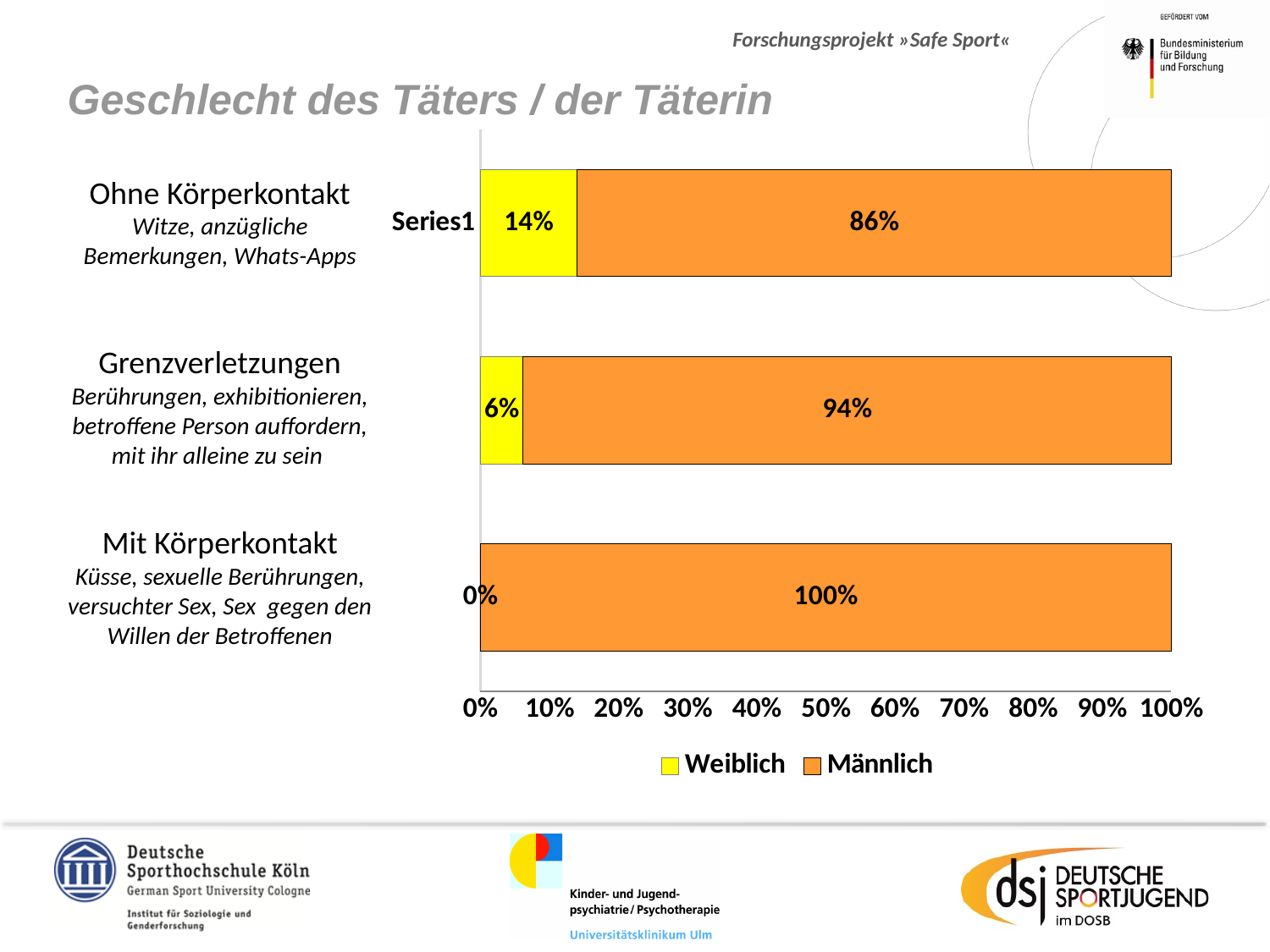
Which is larger for Ohne Körperkontakt, the Weiblich share or the Männlich share? Männlich What is the Männlich share for Ohne Körperkontakt? 86% What kind of chart is shown on the slide? stacked bar chart What is the Weiblich share for Grenzverletzungen? 6% How many series does the legend list? 2 Which category has the highest Weiblich share? Ohne Körperkontakt What is the difference between the Männlich and Weiblich shares for Grenzverletzungen? 88% How many categories (bars) are shown in the chart? 3 Which category has the lowest Weiblich share? Mit Körperkontakt What is the Männlich share for Mit Körperkontakt? 100% What is the Weiblich share for Ohne Körperkontakt? 14% Which colour represents Weiblich in the chart? yellow